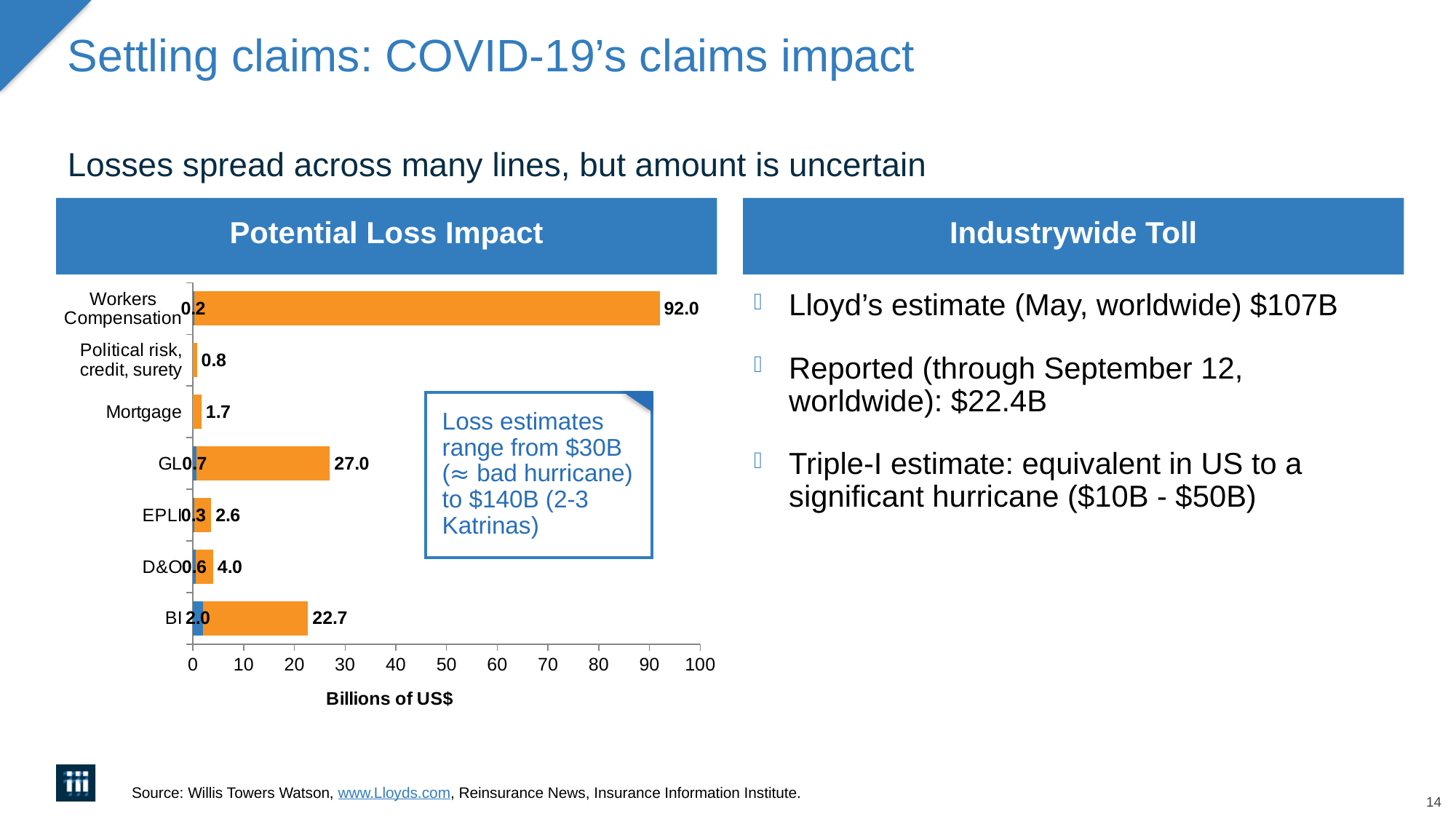
What is the difference between the orange-bar values for GL and BI in the Potential Loss Impact chart? 4.3 Which category has the lowest orange-bar value in the Potential Loss Impact chart? Political risk, credit, surety Is the orange-bar value for Workers Compensation in the Potential Loss Impact chart greater or less than 90? greater What type of chart is the Potential Loss Impact chart? Bar chart What is the larger (orange bar) value for GL in the Potential Loss Impact chart? 27.0 Which category has the highest value in the Potential Loss Impact chart? Workers Compensation What is the larger (orange bar) value for Workers Compensation in the Potential Loss Impact chart? 92.0 What is the smaller (blue bar) value for BI in the Potential Loss Impact chart? 2.0 How many categories are shown in the Potential Loss Impact chart? 7 What is the value shown for Mortgage in the Potential Loss Impact chart? 1.7 In the Potential Loss Impact chart, which has a larger orange-bar value, D&O or EPLI? D&O What is the larger (orange bar) value for BI in the Potential Loss Impact chart? 22.7